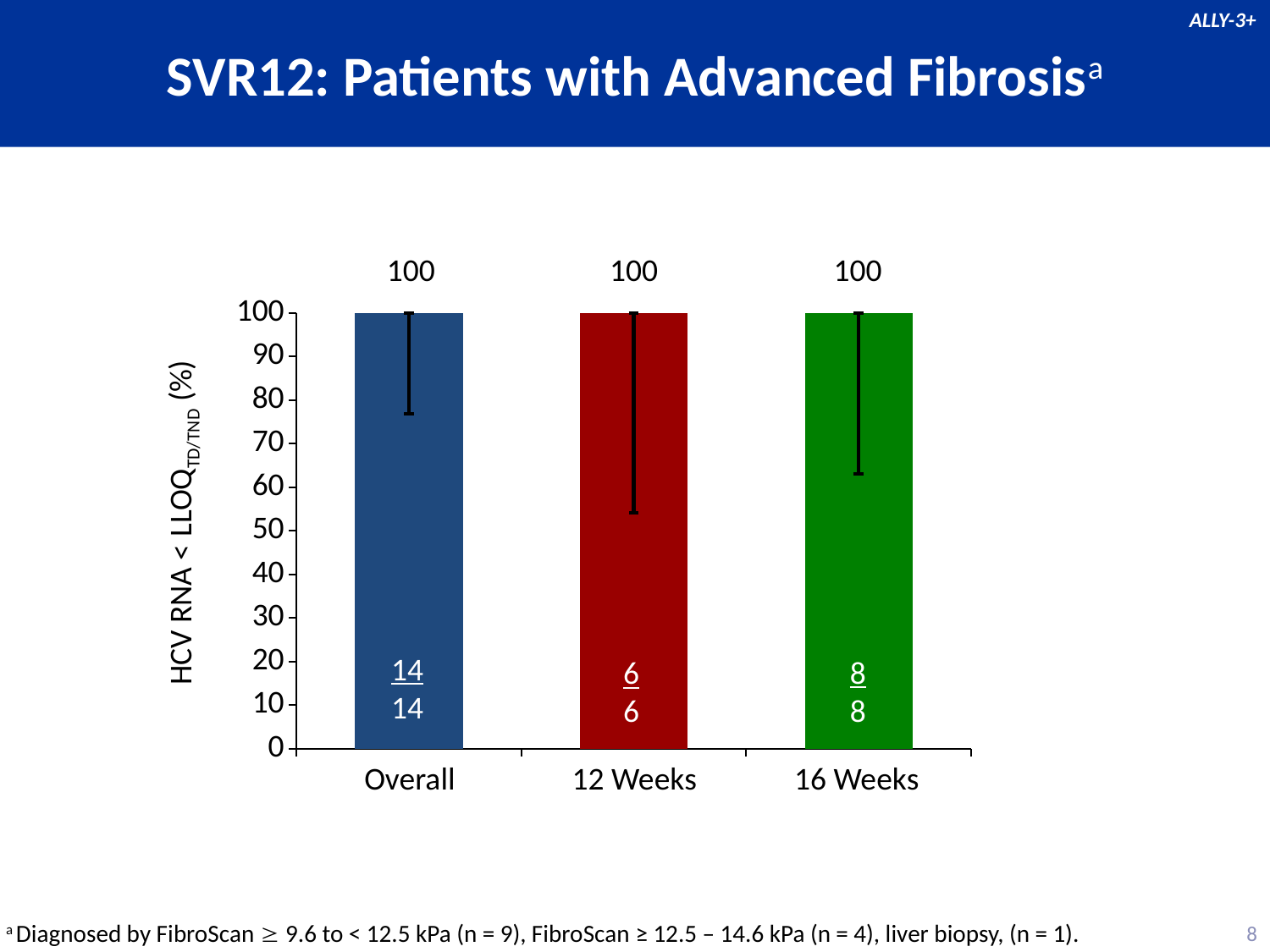
What kind of chart is shown on the slide? Bar chart What is the value for Overall? 100 What fraction of patients is shown inside the 16 Weeks bar? 8/8 What fraction of patients is shown inside the Overall bar? 14/14 What is the title of the chart? SVR12: Patients with Advanced Fibrosis What is the difference between the values for Overall and 16 Weeks? 0 What fraction of patients is shown inside the 12 Weeks bar? 6/6 How many categories are shown on the x axis? 3 What is the value for 16 Weeks? 100 What is the value for 12 Weeks? 100 What colour is the 16 Weeks bar? Green Is the value for 12 Weeks greater or less than 50? greater